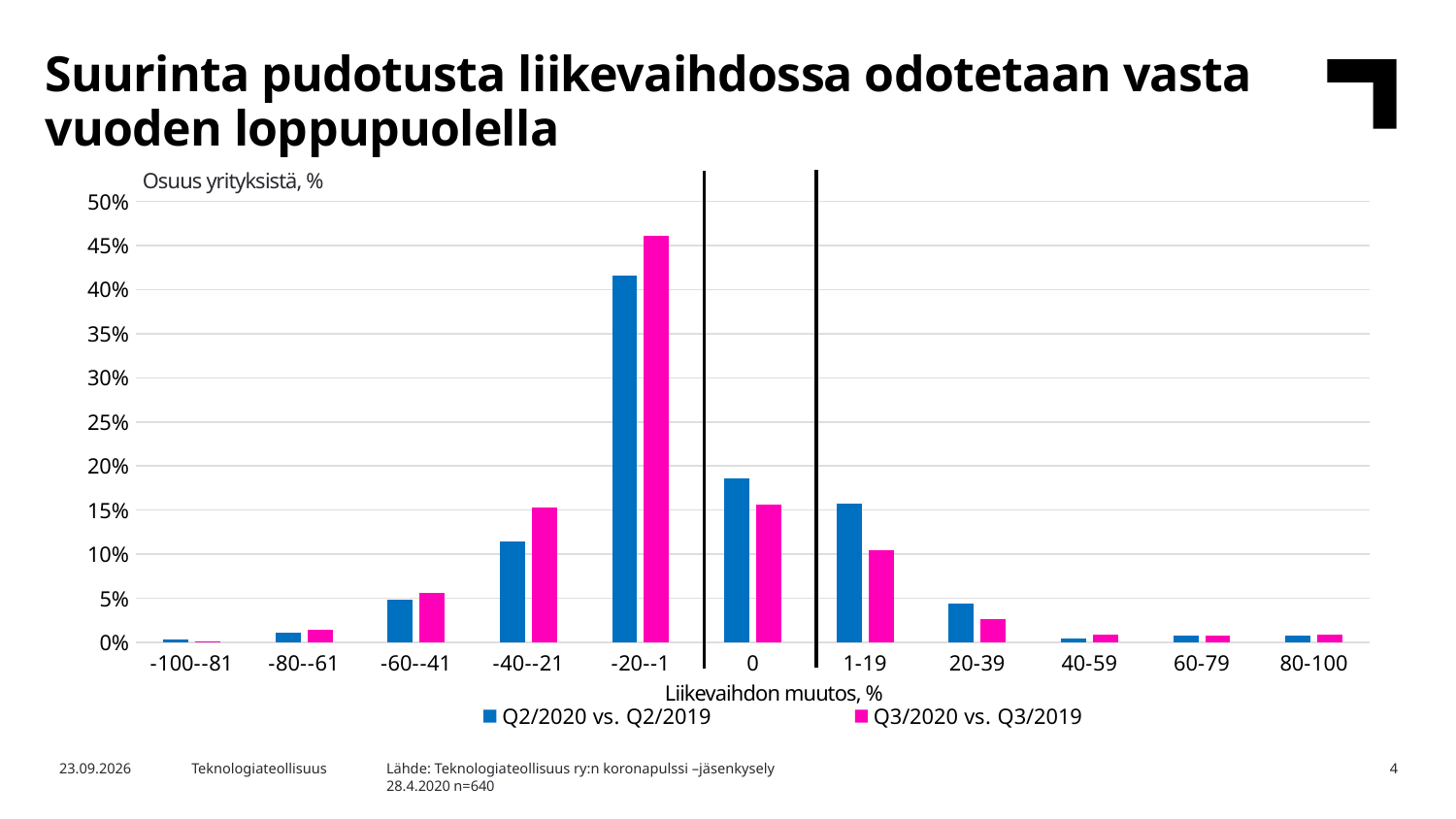
In the 0 category, which series has the larger value, Q2/2020 vs. Q2/2019 or Q3/2020 vs. Q3/2019? Q2/2020 vs. Q2/2019 Which category has the lowest value for the Q3/2020 vs. Q3/2019 series? -100--81 What is the title of the x axis of the chart? Liikevaihdon muutos, % Is the value for Q2/2020 vs. Q2/2019 in the 20-39 category greater or less than 5%? less How many series does the legend list? 2 How many categories are shown on the x axis? 11 What kind of chart is shown on the slide? bar chart Is the value for Q2/2020 vs. Q2/2019 in the 0 category greater or less than 15%? greater In the -40--21 category, which series has the larger value, Q2/2020 vs. Q2/2019 or Q3/2020 vs. Q3/2019? Q3/2020 vs. Q3/2019 Which category has the highest value for the Q3/2020 vs. Q3/2019 series? -20--1 Which category has the highest value for the Q2/2020 vs. Q2/2019 series? -20--1 Is the value for Q3/2020 vs. Q3/2019 in the -20--1 category greater or less than 40%? greater